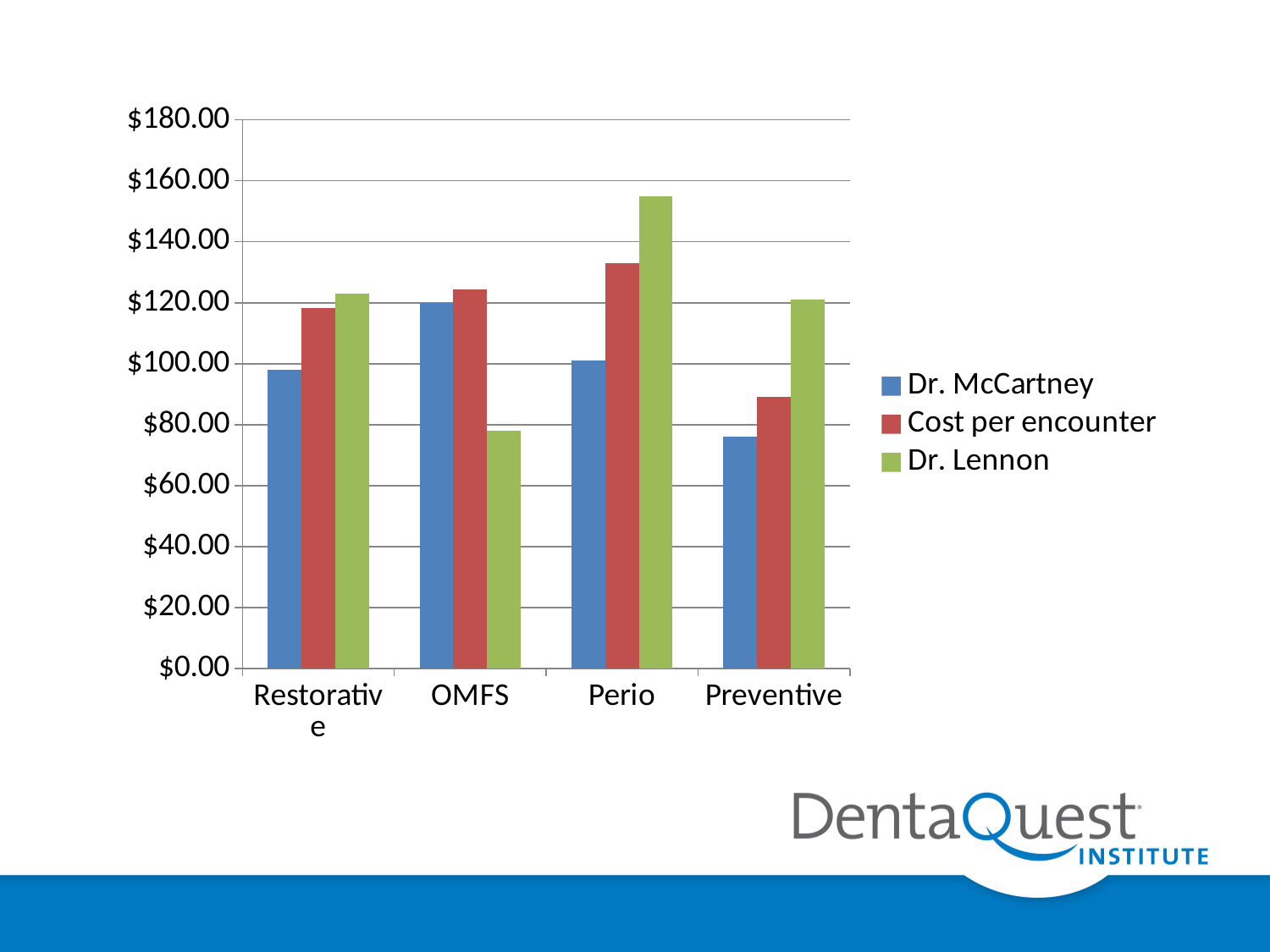
For which category is the Dr. McCartney value highest? OMFS For which category is the Dr. McCartney value lowest? Preventive Is the Dr. Lennon value for Perio greater or less than $140.00? greater For which category is the Dr. Lennon value highest? Perio For which category is the Dr. Lennon value lowest? OMFS How many categories are shown on the x axis? 4 Is the Dr. McCartney value for Preventive greater or less than $80.00? less Is the Cost per encounter value for Perio greater or less than $120.00? greater Which legend entry is shown in green? Dr. Lennon For OMFS, which is larger: the Dr. McCartney value or the Dr. Lennon value? Dr. McCartney How many series does the legend list? 3 What kind of chart is shown on the slide? bar chart